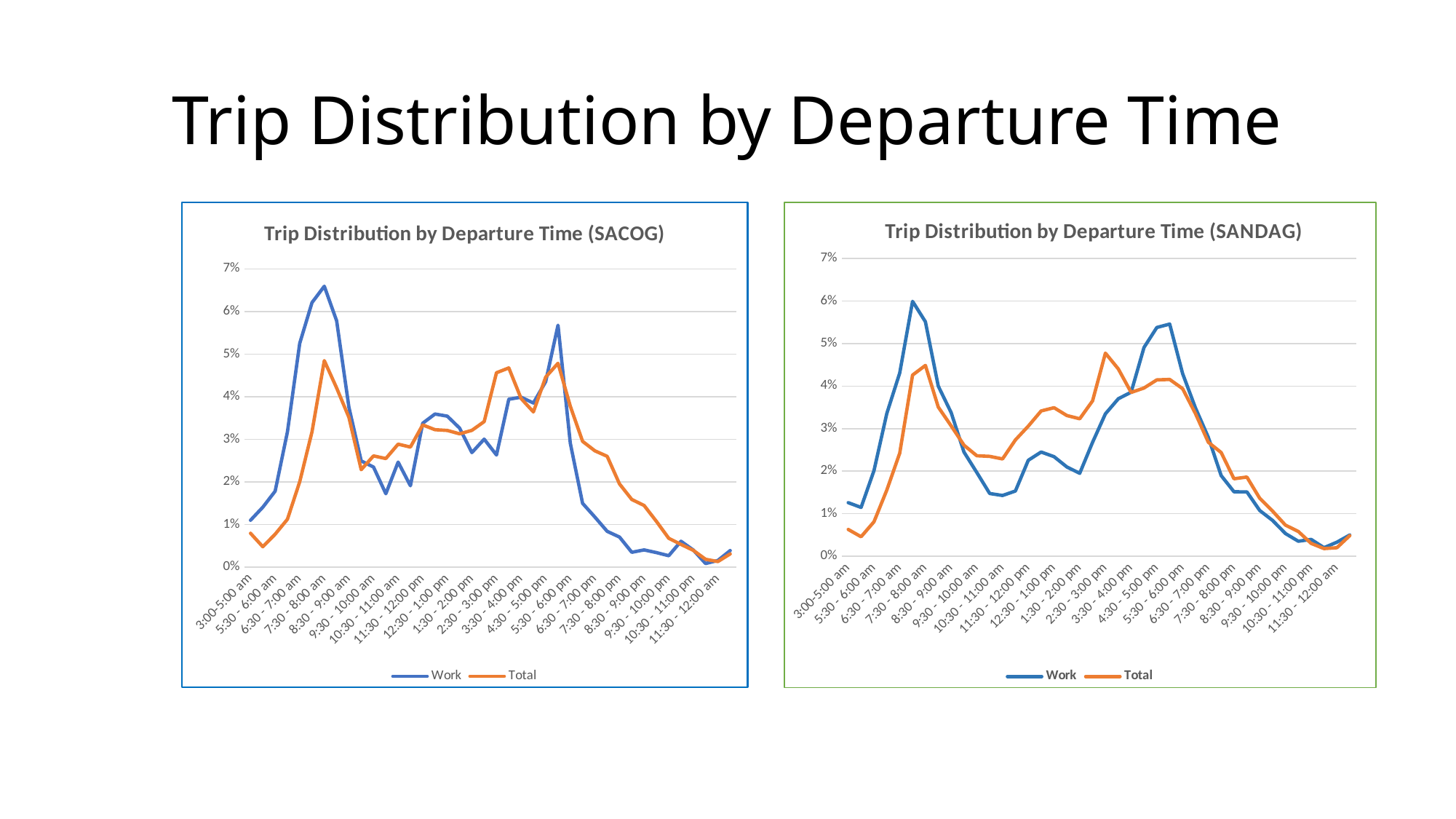
How many series does the legend of the Trip Distribution by Departure Time (SANDAG) chart list? 2 In the Trip Distribution by Departure Time (SACOG) chart, is the Total value at 7:30 - 8:00 am greater or less than 5%? less What kind of chart is the Trip Distribution by Departure Time (SACOG) chart? line chart In the Trip Distribution by Departure Time (SANDAG) chart, is the Work value at 10:30 - 11:00 am greater or less than 2%? less In the Trip Distribution by Departure Time (SANDAG) chart, at 2:30 - 3:00 pm, which series has the larger value, Work or Total? Total In the Trip Distribution by Departure Time (SACOG) chart, which series is drawn in orange? Total In the Trip Distribution by Departure Time (SANDAG) chart, is the Work value at 5:30 - 6:00 pm greater or less than 5%? less In the Trip Distribution by Departure Time (SANDAG) chart, does the Total series rise or fall from 5:30 - 6:00 pm to 11:30 - 12:00 am? fall In the Trip Distribution by Departure Time (SACOG) chart, at which departure time does the Work series reach its highest value? 7:30 - 8:00 am In the Trip Distribution by Departure Time (SACOG) chart, at 7:30 - 8:00 am, which series has the larger value, Work or Total? Work